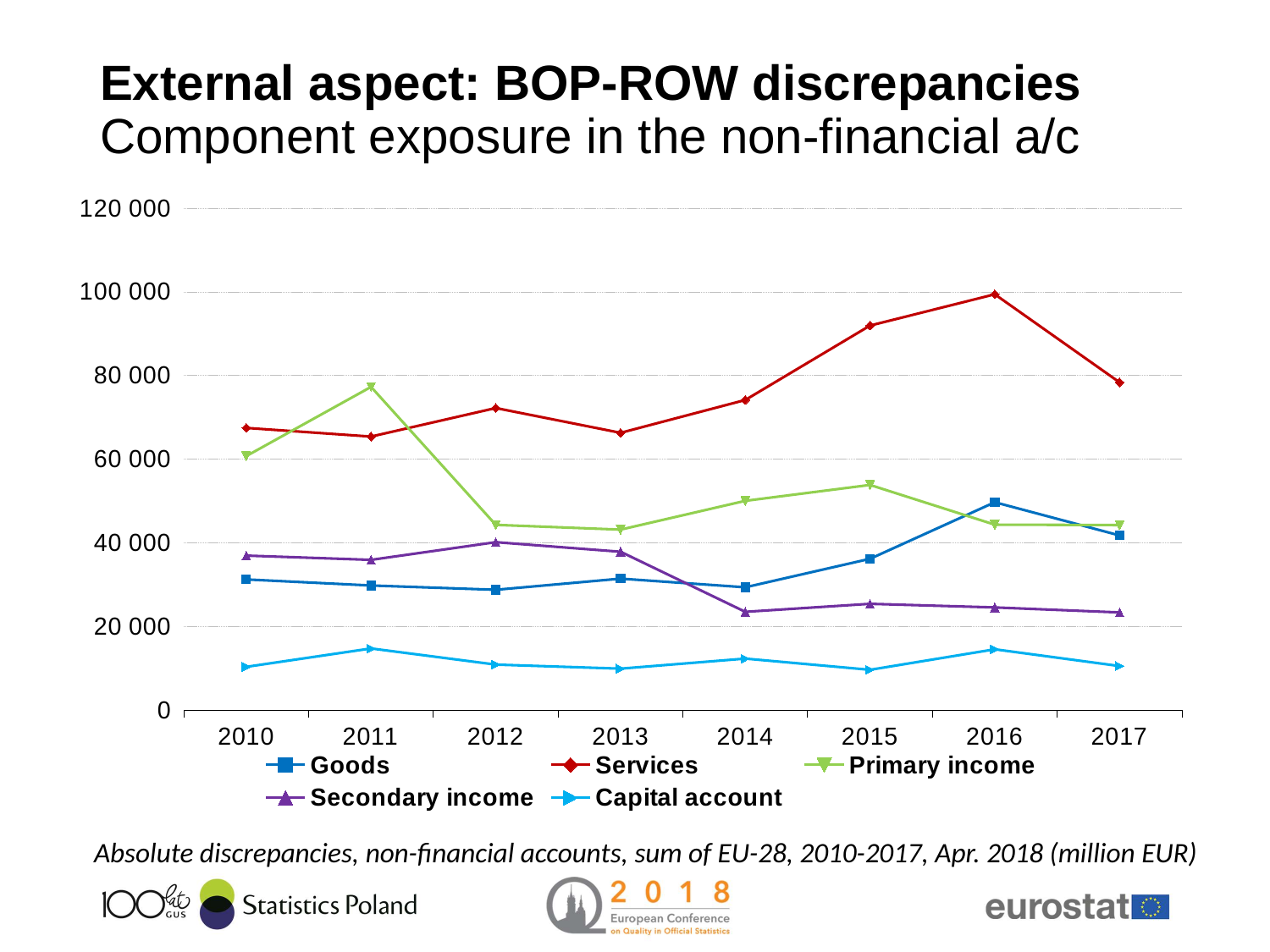
What kind of chart is shown on the slide? line chart Is the value for Primary income in 2011 greater or less than 60 000? greater Is the value for Capital account in 2011 greater or less than 20 000? less Does the Services series rise or fall from 2013 to 2016? rise How many years are plotted along the x axis? 8 According to the note below the chart, in what unit are the values expressed? million EUR In which year does the Services series reach its highest value? 2016 Is the value for Services in 2016 greater or less than 80 000? greater How many series does the legend list? 5 In 2010, which is larger: Goods or Secondary income? Secondary income In 2011, which is larger: Services or Primary income? Primary income Which series has the lowest value in 2017? Capital account